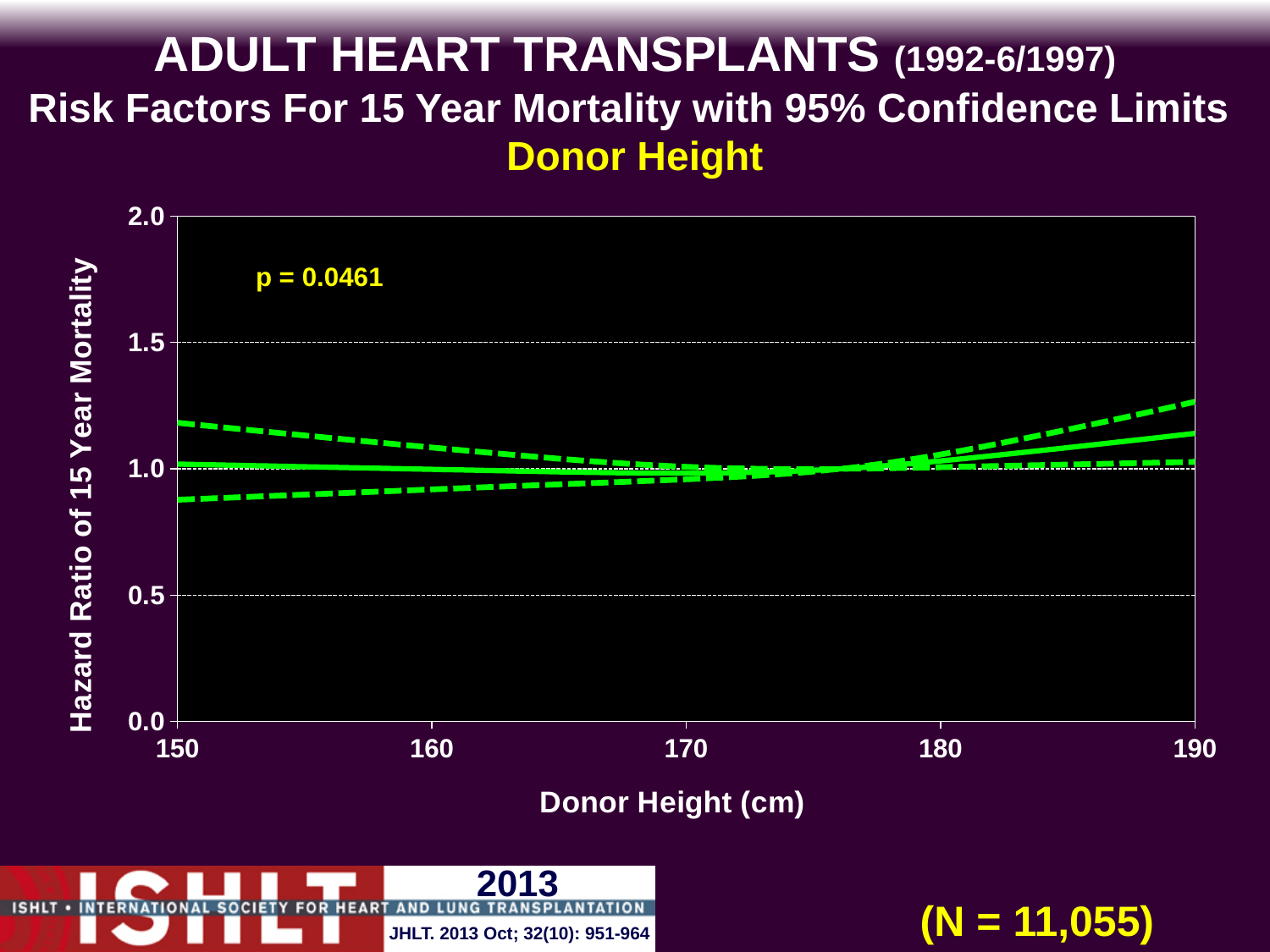
What is the label of the y axis? Hazard Ratio of 15 Year Mortality What is the sample size (N) shown on the slide? N = 11,055 What is the highest value shown on the y axis? 2.0 Is the lower confidence limit (lower dashed line) at a donor height of 150 cm greater or less than 1.0? less What is the p-value printed on the chart? p = 0.0461 What is the label of the x axis? Donor Height (cm) Does the hazard ratio (solid line) rise or fall overall as donor height increases from 150 cm to 190 cm? rise What kind of chart is shown on the slide? line chart Is the upper confidence limit (upper dashed line) at a donor height of 190 cm greater or less than 1.5? less Is the hazard ratio (solid line) at a donor height of 190 cm greater or less than 1.0? greater What range of donor height does the x axis cover? 150 to 190 cm